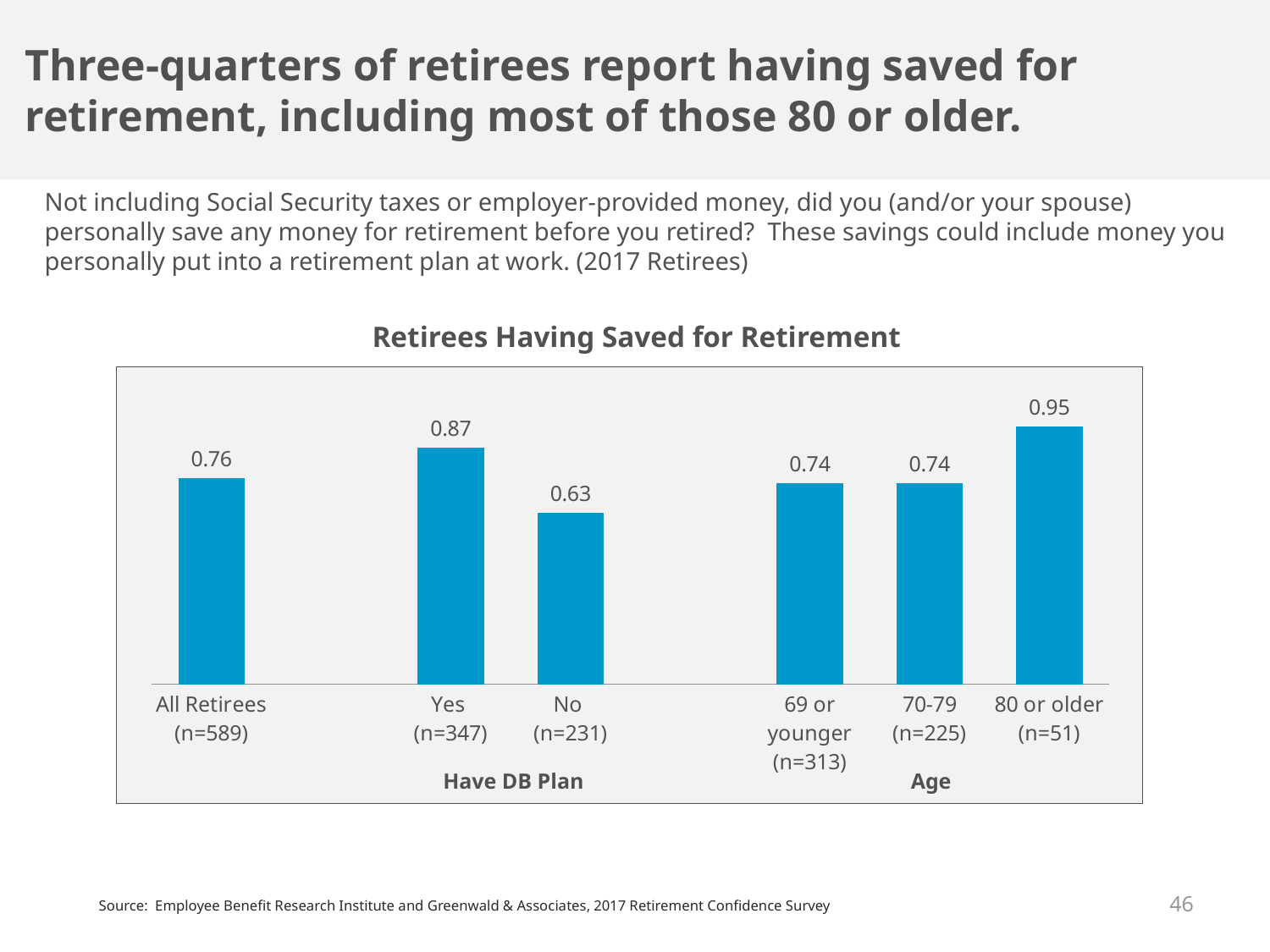
Which category has the highest value? 80 or older (n=51) What is the value for retirees aged 80 or older (n=51)? 0.95 Which is larger, the value for All Retirees or the value for Yes (Have DB Plan)? Yes (Have DB Plan) What is the value for retirees who do not have a DB plan (No, n=231)? 0.63 What is the title of the chart? Retirees Having Saved for Retirement How many bars are plotted in the chart? 6 What kind of chart is shown on the slide? Bar chart What is the value for All Retirees (n=589)? 0.76 Which category has the lowest value? No (n=231) What is the difference between the values for Yes (n=347) and No (n=231) under Have DB Plan? 0.24 What is the value for retirees who have a DB plan (Yes, n=347)? 0.87 What is the difference between the values for 80 or older and 70-79? 0.21